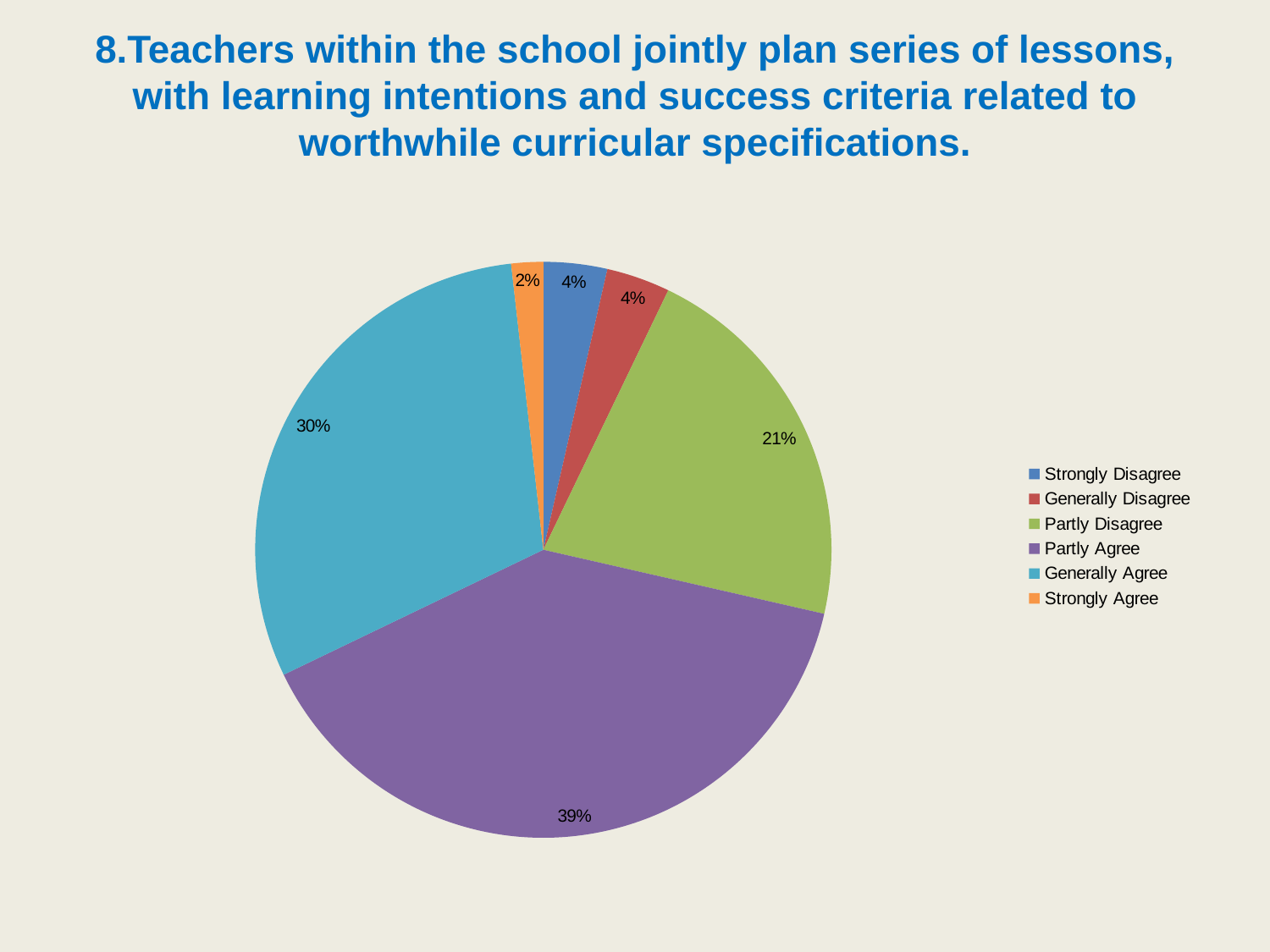
What percentage of respondents chose Partly Disagree? 21% What is the difference in percentage points between Partly Agree and Generally Agree? 9 Which response category has the smallest share of the pie? Strongly Agree What percentage of respondents chose Generally Agree? 30% Which is larger, the share for Partly Disagree or the share for Generally Agree? Generally Agree What percentage of respondents chose Partly Agree? 39% What colour is the Partly Agree slice? purple What percentage of respondents chose Strongly Agree? 2% How many categories does the legend list? 6 Which response category has the largest share of the pie? Partly Agree What percentage of respondents chose Strongly Disagree? 4% What type of chart is shown on the slide? pie chart